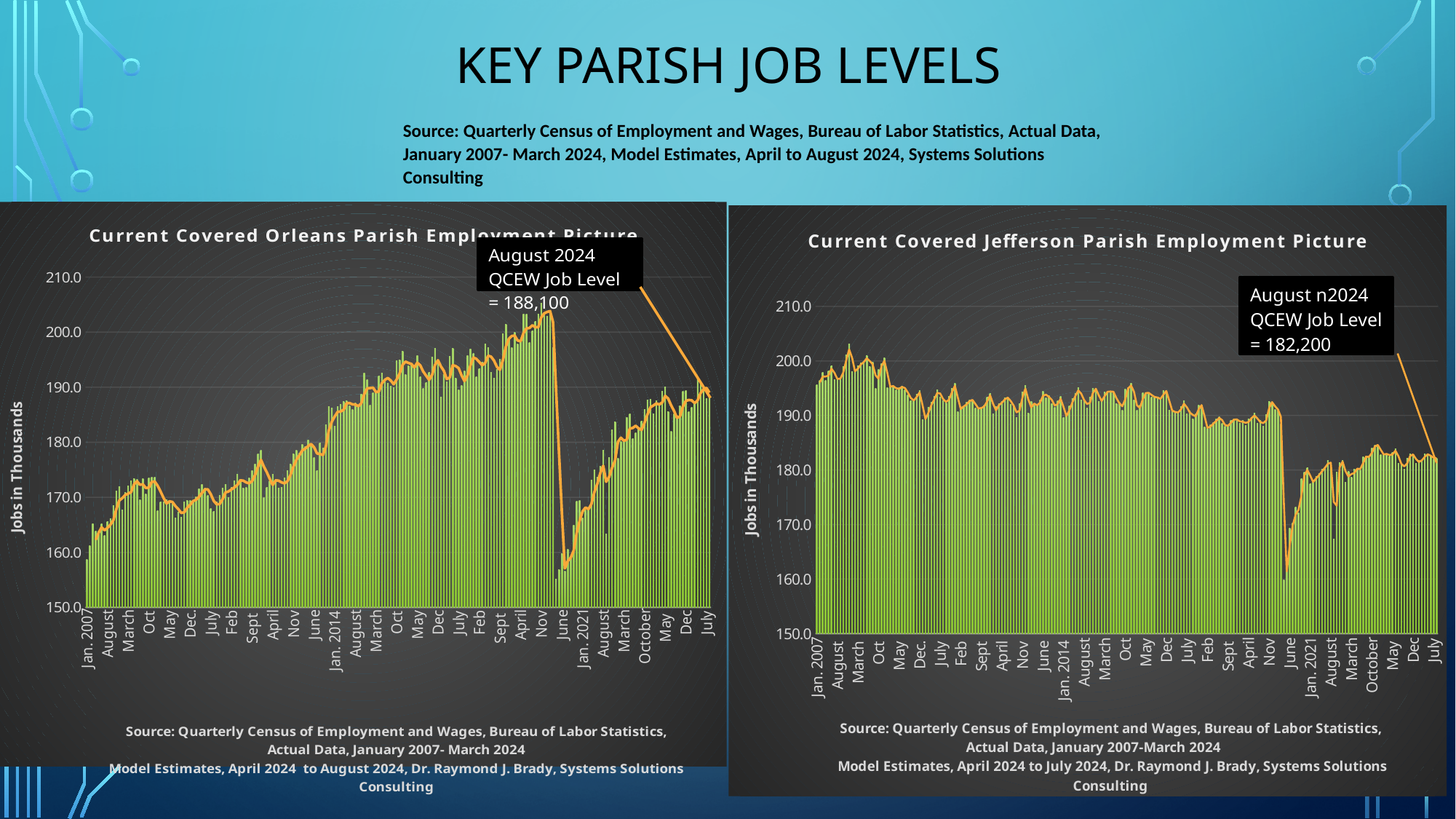
What kind of chart is the Current Covered Orleans Parish Employment Picture chart? Bar chart What is the y-axis label on the Current Covered Jefferson Parish Employment Picture chart? Jobs in Thousands On the Current Covered Jefferson Parish Employment Picture chart, is the value for Jan. 2007 greater or less than 190? greater On the Current Covered Orleans Parish Employment Picture chart, is the value at the June 2020 dip greater or less than 160? less On the Current Covered Orleans Parish Employment Picture chart, do the values generally rise or fall from Jan. 2007 to the end of 2019? rise On the Current Covered Orleans Parish Employment Picture chart, is the peak value reached just before the 2020 drop greater or less than 200? greater Which parish has the higher annotated August 2024 QCEW job level, Orleans or Jefferson? Orleans On the Current Covered Orleans Parish Employment Picture chart, what is the August 2024 QCEW job level shown in the annotation? 188,100 On the Current Covered Jefferson Parish Employment Picture chart, what is the August 2024 QCEW job level shown in the annotation? 182,200 On the Current Covered Jefferson Parish Employment Picture chart, is the July 2024 value higher or lower than the Jan. 2007 value? lower Comparing the annotated August 2024 QCEW job levels on the two charts, how much higher is Orleans Parish than Jefferson Parish? 5,900